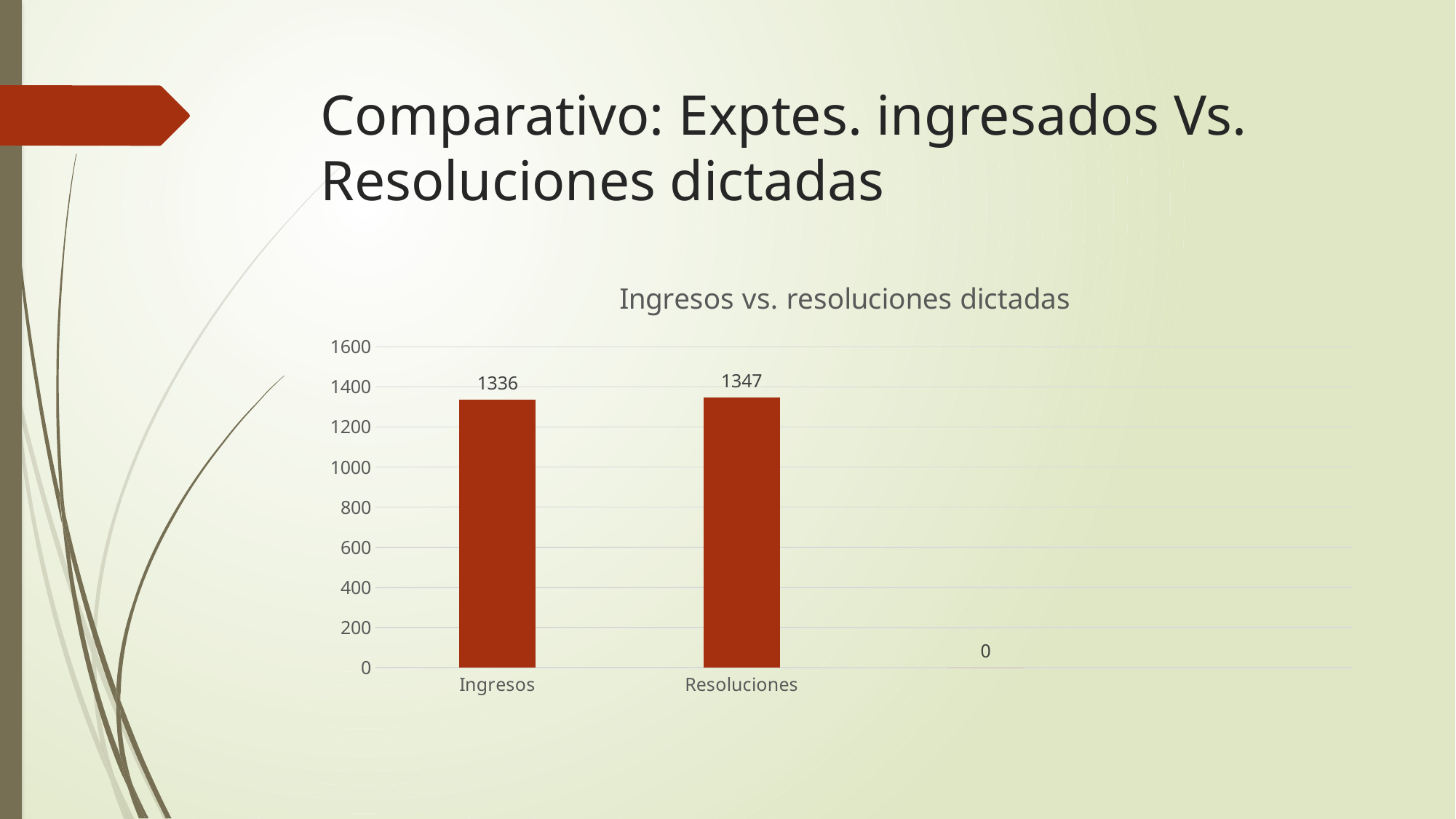
How many labelled categories appear on the x axis? 2 What is the value for Ingresos? 1336 Which labelled category has the highest value? Resoluciones What is the value for Resoluciones? 1347 Is the value for Ingresos greater or less than 1200? greater What is the difference between the values for Resoluciones and Ingresos? 11 Which labelled category has the lowest value? Ingresos What is the title of the chart? Ingresos vs. resoluciones dictadas Which category has the higher value, Ingresos or Resoluciones? Resoluciones What kind of chart is shown on the slide? Bar chart What is the highest value shown on the vertical axis? 1600 Is the value for Resoluciones greater or less than 1400? less